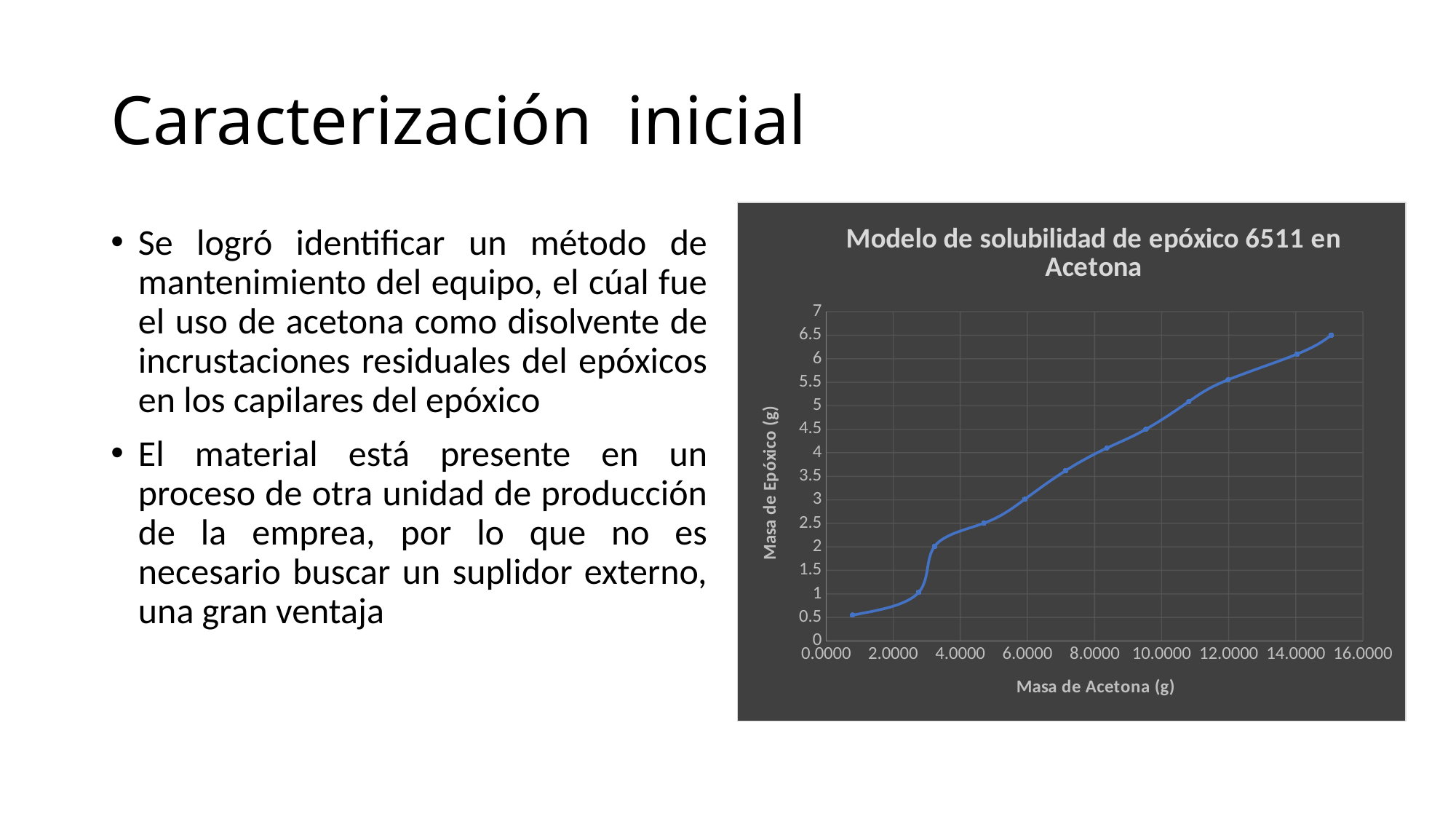
What kind of chart is shown on the slide? line chart Which point has the higher Masa de Epóxico: the one at the smallest Masa de Acetona or the one at the largest Masa de Acetona? the one at the largest Masa de Acetona What is the label of the x axis of the chart? Masa de Acetona (g) Does the mass of epoxy rise or fall as the mass of acetone increases along the x axis? rise What is the title of the chart? Modelo de solubilidad de epóxico 6511 en Acetona What is the maximum value shown on the y axis of the chart? 7 Is the Masa de Epóxico at a Masa de Acetona of about 6 g greater or less than 2.5? greater Is the value of Masa de Epóxico at the point with the largest Masa de Acetona greater or less than 7? less How many data points are plotted on the chart? 12 Is the lowest plotted value of Masa de Epóxico greater or less than 1? less